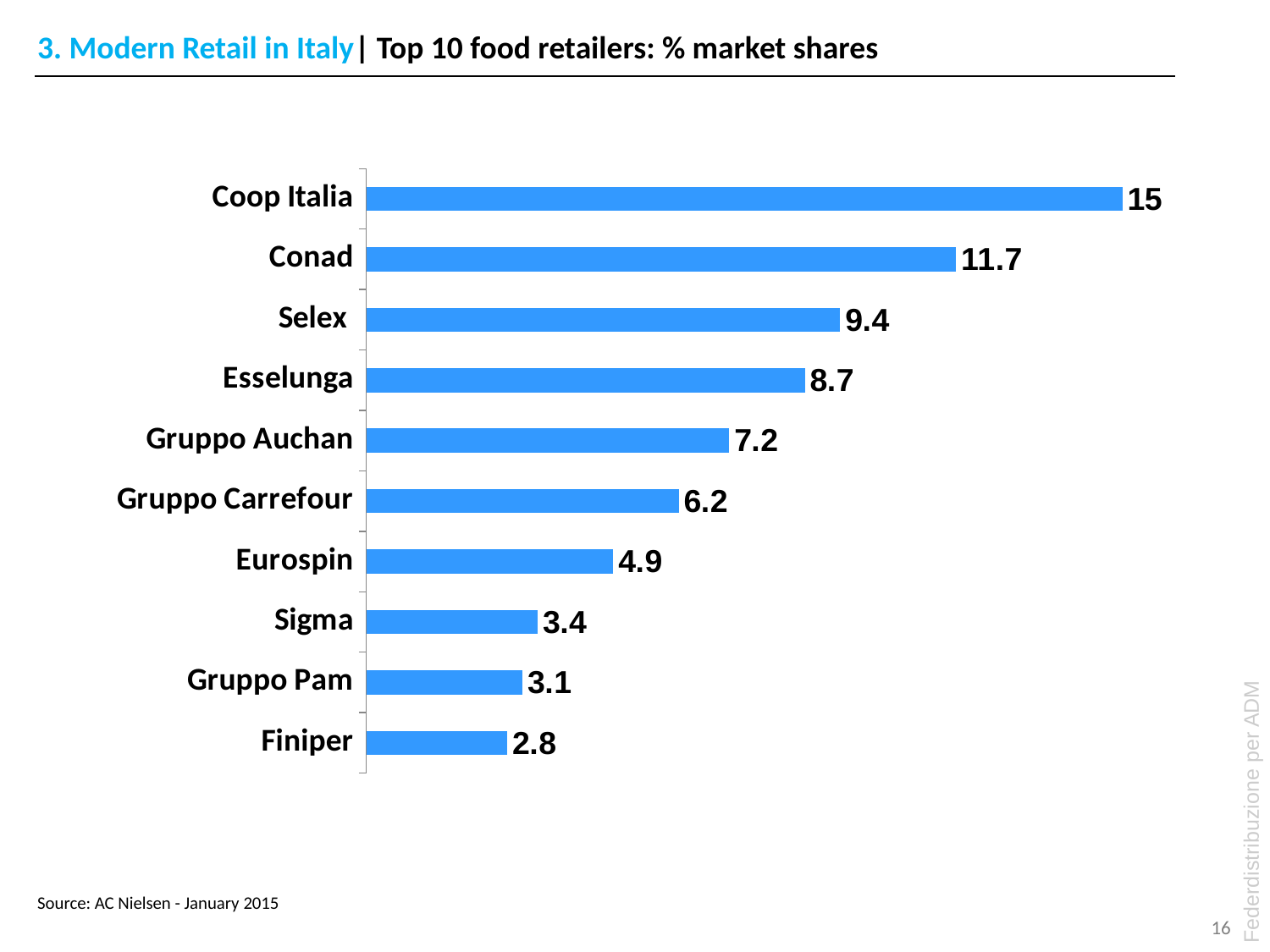
What is the market share value shown for Conad? 11.7 Which has a larger market share, Gruppo Auchan or Eurospin? Gruppo Auchan What is the market share value shown for Sigma? 3.4 Which has a larger market share, Gruppo Pam or Finiper? Gruppo Pam What kind of chart is shown on the slide? Bar chart Which retailer has the highest market share? Coop Italia How many retailers are shown in the chart? 10 What is the difference between the market shares of Selex and Esselunga? 0.7 What is the difference between the market shares of Coop Italia and Conad? 3.3 What is the source cited for the chart data? AC Nielsen - January 2015 What is the market share value shown for Gruppo Carrefour? 6.2 Which retailer has the lowest market share? Finiper